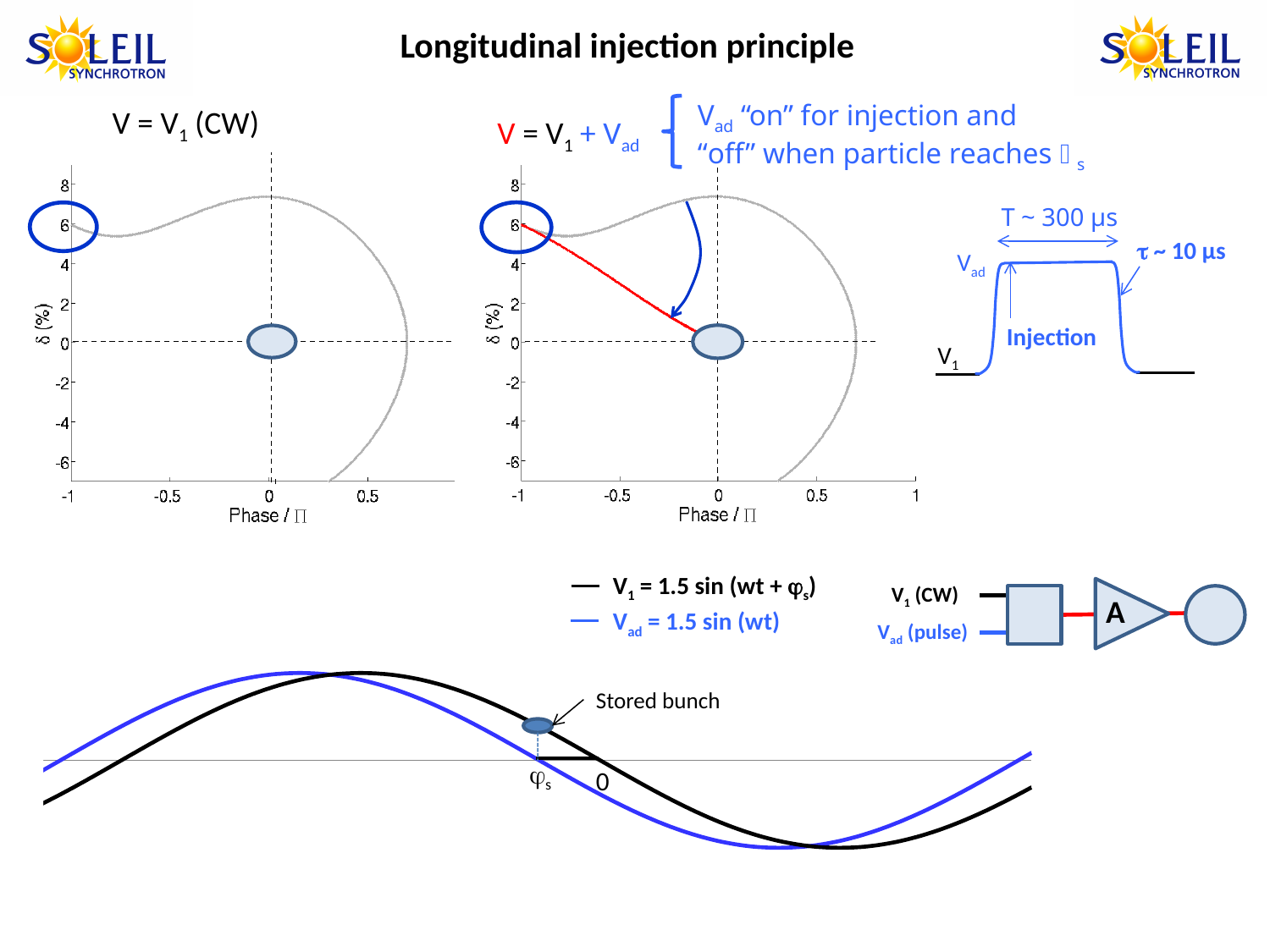
What is the maximum x-axis tick value on the right phase-space plot (V = V1 + Vad)? 1 What is the lowest tick value on the y-axis of the left phase-space plot? -6 In the pulse diagram on the right, what is the pulse duration T of Vad? T ~ 300 µs What is the y-axis label of the left phase-space plot? δ (%) How many series does the legend of the bottom sine-wave plot list? 2 In the pulse diagram on the right, what is the rise/fall time τ? τ ~ 10 µs What kind of chart is the bottom plot showing V1 and Vad? Line chart In the bottom sine-wave plot, what is the amplitude of Vad according to the legend formula? 1.5 What is the highest tick value on the y-axis of the left phase-space plot? 8 In the bottom sine-wave plot, which colour represents V1 according to the legend? Black How many phase-space plots (δ vs Phase/π) are shown on the slide? 2